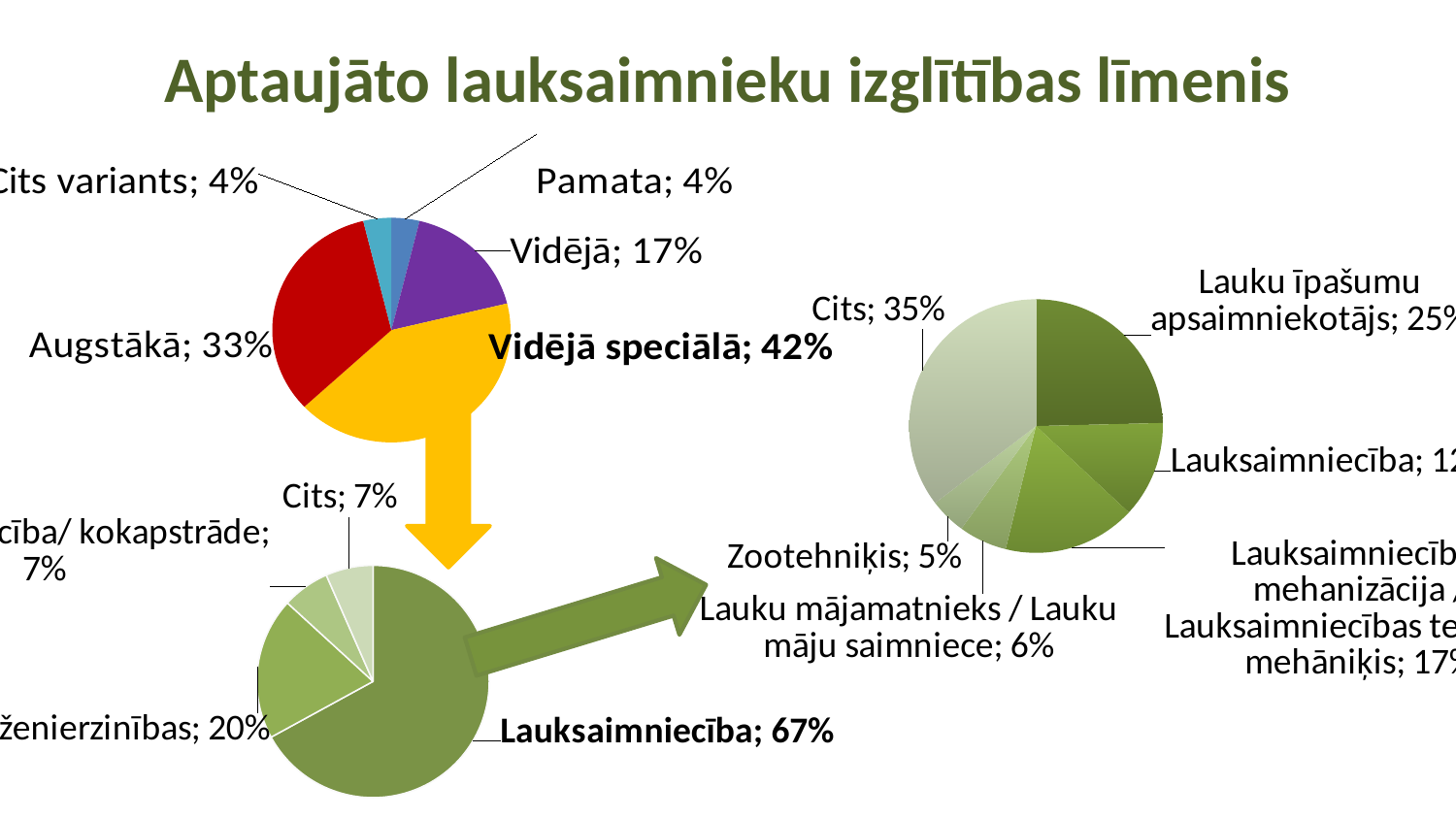
On the top-left pie chart, what is the difference between the Vidējā speciālā share and the Vidējā share? 25 percentage points On the right pie chart, what share is labelled Zootehniķis? 5% On the top-left pie chart, what share is labelled Augstākā? 33% On the bottom-left pie chart, what share is labelled Lauksaimniecība? 67% On the right pie chart, what share is labelled Cits? 35% How many slices does the top-left pie chart have? 5 On the top-left pie chart, which is larger: Augstākā or Vidējā? Augstākā On the right pie chart, which is larger: Lauku īpašumu apsaimniekotājs or Zootehniķis? Lauku īpašumu apsaimniekotājs What kind of chart is the top-left chart? Pie chart On the bottom-left pie chart, what share is labelled Cits? 7% On the top-left pie chart, what share is labelled Vidējā speciālā? 42% On the top-left pie chart, which category has the largest share? Vidējā speciālā